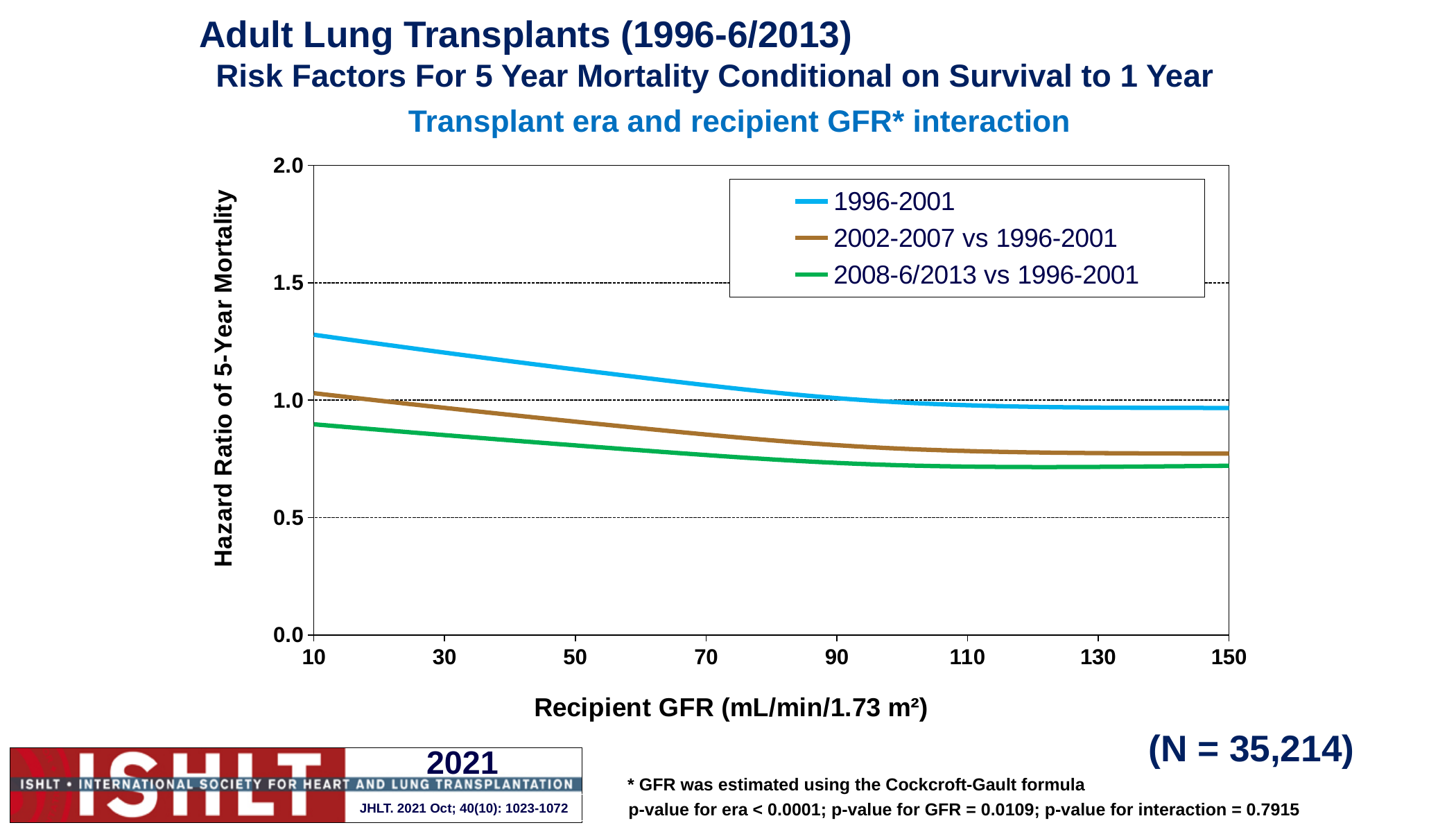
Which series has the lowest hazard ratio across the GFR range? 2008-6/2013 vs 1996-2001 Is the hazard ratio for the 2008-6/2013 vs 1996-2001 series at a recipient GFR of 10 greater or less than 1.0? less Is the hazard ratio for the 2008-6/2013 vs 1996-2001 series at a recipient GFR of 150 greater or less than 0.5? greater Is the hazard ratio for the 2002-2007 vs 1996-2001 series at a recipient GFR of 150 greater or less than 1.0? less How many series does the legend list? 3 What is the label of the y axis? Hazard Ratio of 5-Year Mortality Which series has the highest hazard ratio at a recipient GFR of 10? 1996-2001 What is the subtitle of the chart shown in blue? Transplant era and recipient GFR* interaction At a recipient GFR of 50, which series has the larger hazard ratio: 1996-2001 or 2008-6/2013 vs 1996-2001? 1996-2001 What kind of chart is shown on the slide? line chart Does the hazard ratio for the 1996-2001 series rise or fall as recipient GFR increases? fall